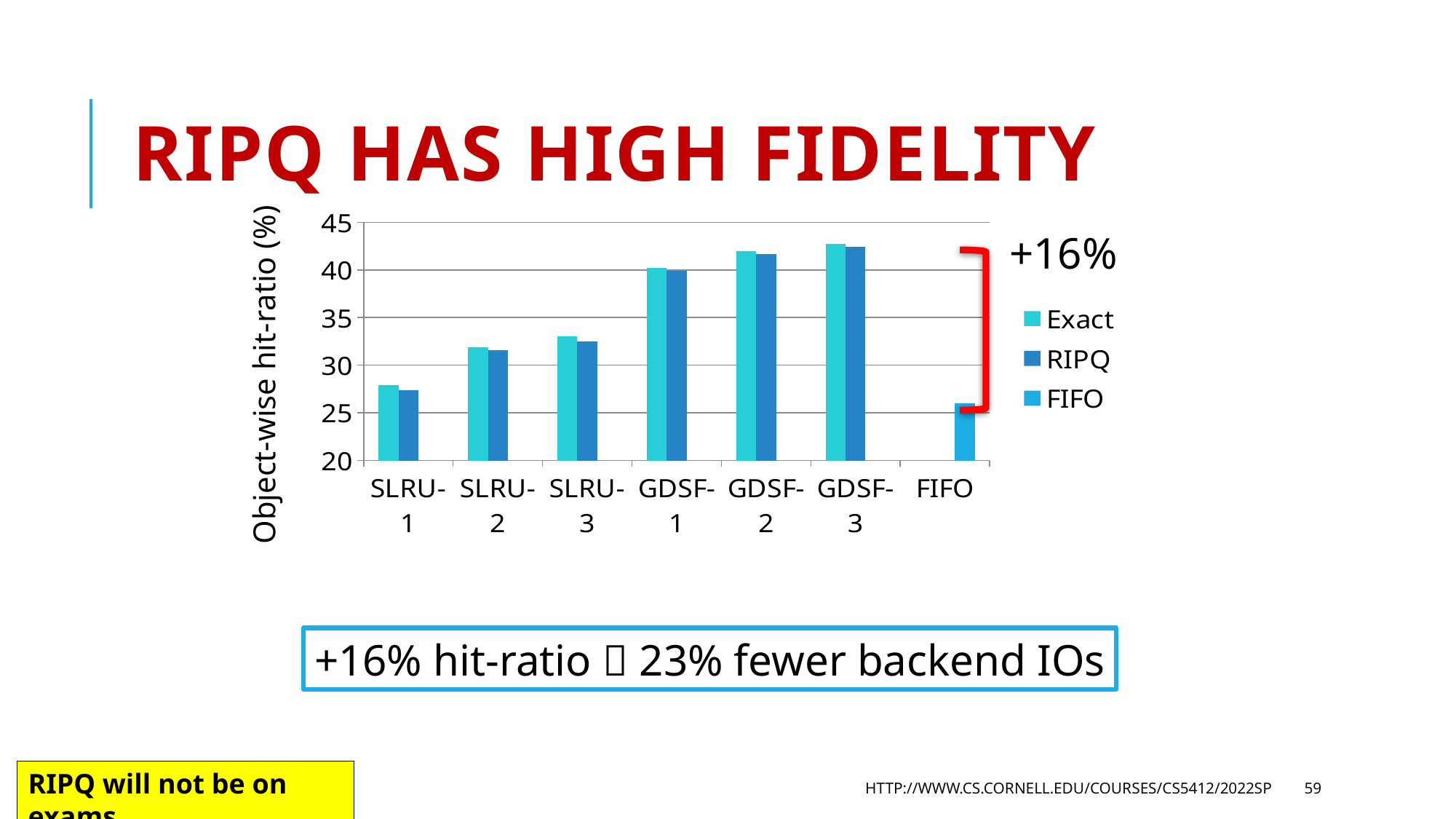
Which category has the lowest Exact value? SLRU-1 Do the Exact values rise or fall from SLRU-1 to GDSF-3 along the x axis? rise Is the RIPQ value for GDSF-3 greater or less than 45? less What is the label of the y axis of the chart? Object-wise hit-ratio (%) Which series are listed in the chart legend? Exact, RIPQ, FIFO Is the Exact value for SLRU-1 greater or less than 30? less What kind of chart is shown on the slide? bar chart Is the Exact value for GDSF-2 greater or less than 40? greater How many categories are shown along the x axis of the chart? 7 Which is larger, the Exact value for SLRU-1 or the Exact value for GDSF-1? GDSF-1 How many series does the chart legend list? 3